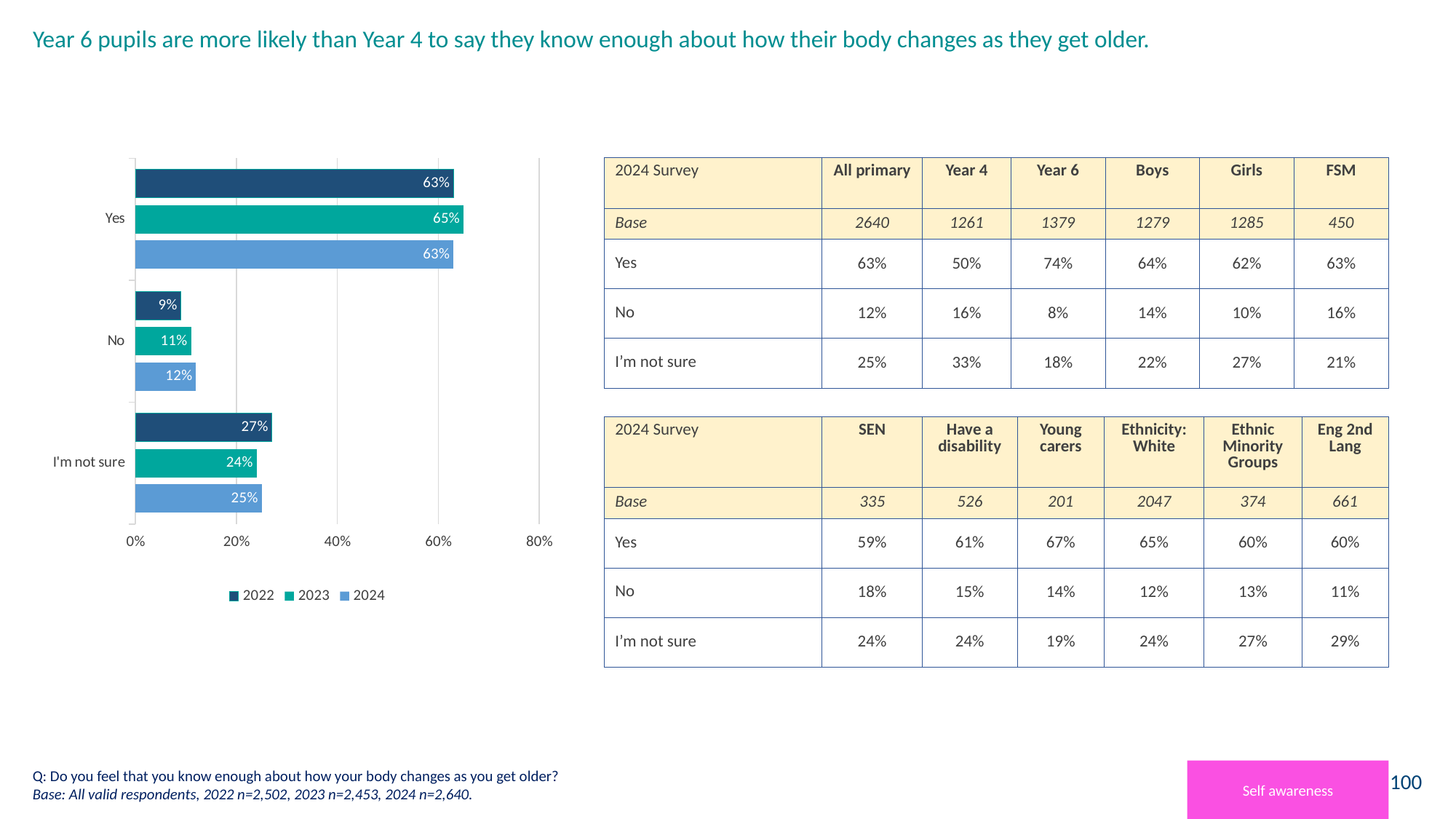
What kind of chart is shown on the slide? bar chart How many series does the legend list? 3 What is the value for 'I'm not sure' in the 2024 series? 25% What is the value for 'No' in the 2022 series? 9% Is the 2022 value for 'Yes' greater or less than 40%? greater What is the value for 'Yes' in the 2023 series? 65% What is the difference between the 2022 and 2023 values for 'I'm not sure'? 3% Which is larger: the 2023 value for 'No' or the 2024 value for 'No'? 2024 Which category has the highest value in the 2024 series? Yes How many categories are shown on the chart? 3 Which category has the lowest value in the 2022 series? No Which series is shown in the darkest blue colour? 2022